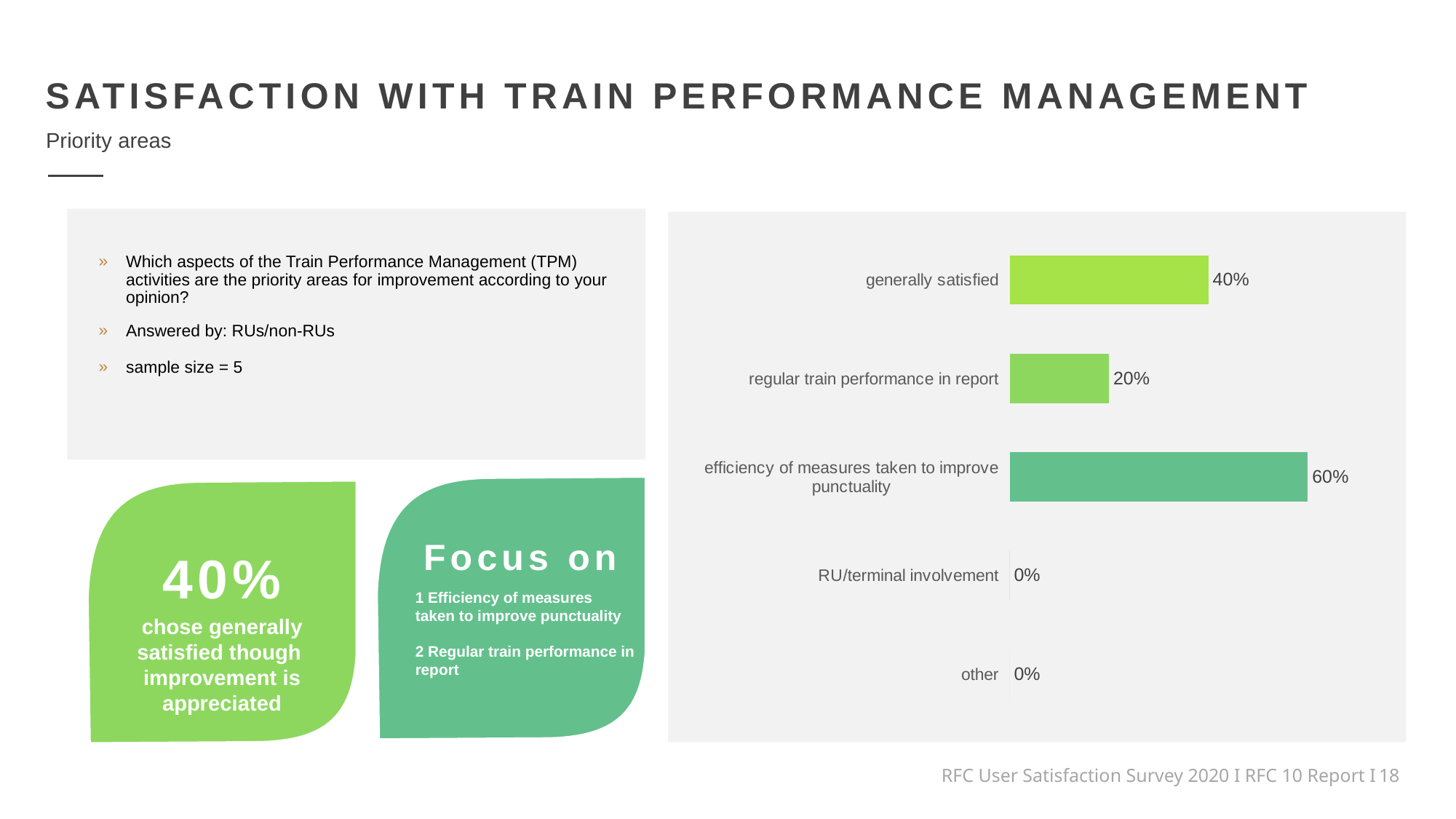
Which category has the highest value? efficiency of measures taken to improve punctuality What is the value for 'generally satisfied'? 40% What kind of chart is shown on the slide? bar chart Which is larger, 'generally satisfied' or 'regular train performance in report'? generally satisfied What is the difference between 'efficiency of measures taken to improve punctuality' and 'generally satisfied'? 20% What is the value for 'efficiency of measures taken to improve punctuality'? 60% What is the difference between 'generally satisfied' and 'regular train performance in report'? 20% How many categories have a value of 0%? 2 What is the value for 'other'? 0% What is the value for 'RU/terminal involvement'? 0% What is the value for 'regular train performance in report'? 20% How many categories are shown in the chart? 5